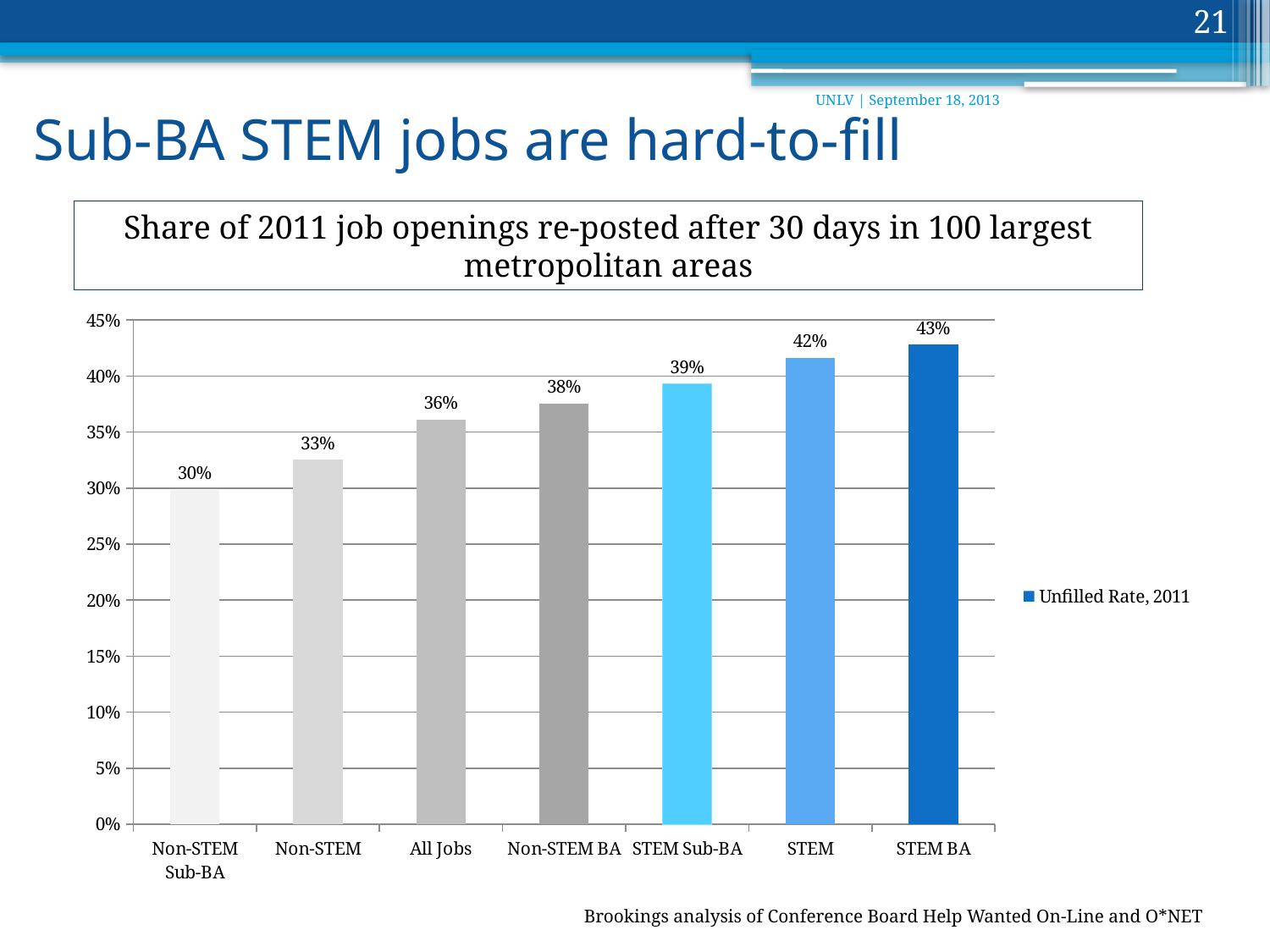
Which has a higher unfilled rate, STEM or Non-STEM? STEM What is the unfilled rate for All Jobs? 36% What is the difference in unfilled rate between STEM Sub-BA and Non-STEM Sub-BA? 9% How many categories are shown on the x axis? 7 Is the unfilled rate for Non-STEM BA greater or less than 35%? greater What kind of chart is shown on the slide? Bar chart How many series does the legend list? 1 What is the unfilled rate for STEM Sub-BA jobs? 39% What is the unfilled rate for Non-STEM Sub-BA jobs? 30% Which category has the lowest unfilled rate? Non-STEM Sub-BA What is the series name shown in the legend? Unfilled Rate, 2011 Which category has the highest unfilled rate? STEM BA